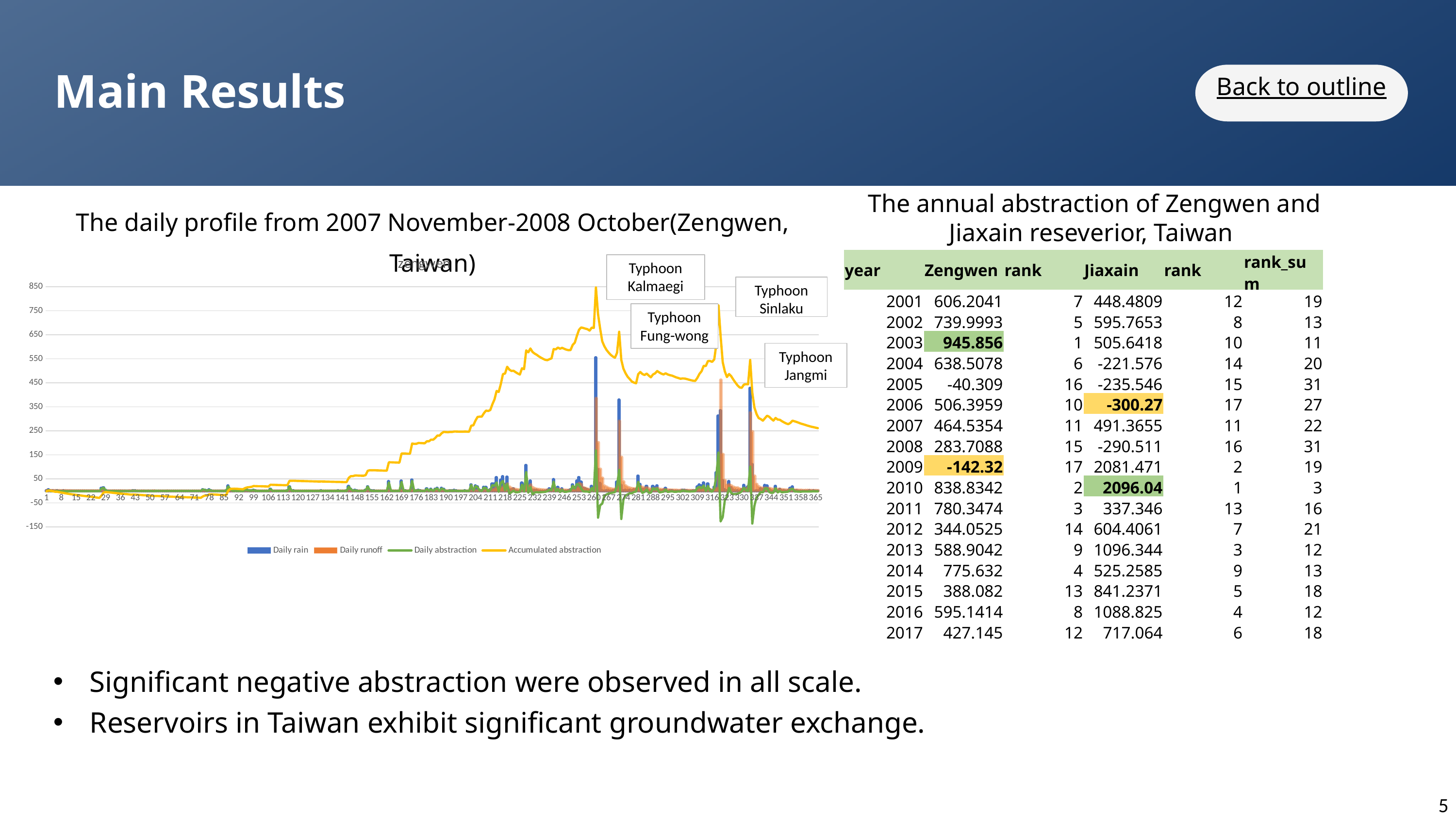
In the daily profile chart, is the largest Daily rain value greater or less than 450? greater What are the four series listed in the legend of the daily profile chart? Daily rain, Daily runoff, Daily abstraction, Accumulated abstraction What is the highest tick value shown on the y axis of the daily profile chart? 850 In the daily profile chart, is the Accumulated abstraction value at day 365 greater or less than 150? greater In the daily profile chart, is the lowest value of Daily abstraction greater or less than -50? less In the daily profile chart, which series reaches the highest value on the y axis? Accumulated abstraction How many typhoons are annotated on the daily profile chart? 4 How many series does the legend of the daily profile chart list? 4 In the daily profile chart, does Accumulated abstraction rise or fall between day 150 and day 250? rise In the daily profile chart, which series is drawn in yellow? Accumulated abstraction In the daily profile chart, is the Accumulated abstraction value larger at day 100 or at day 300? day 300